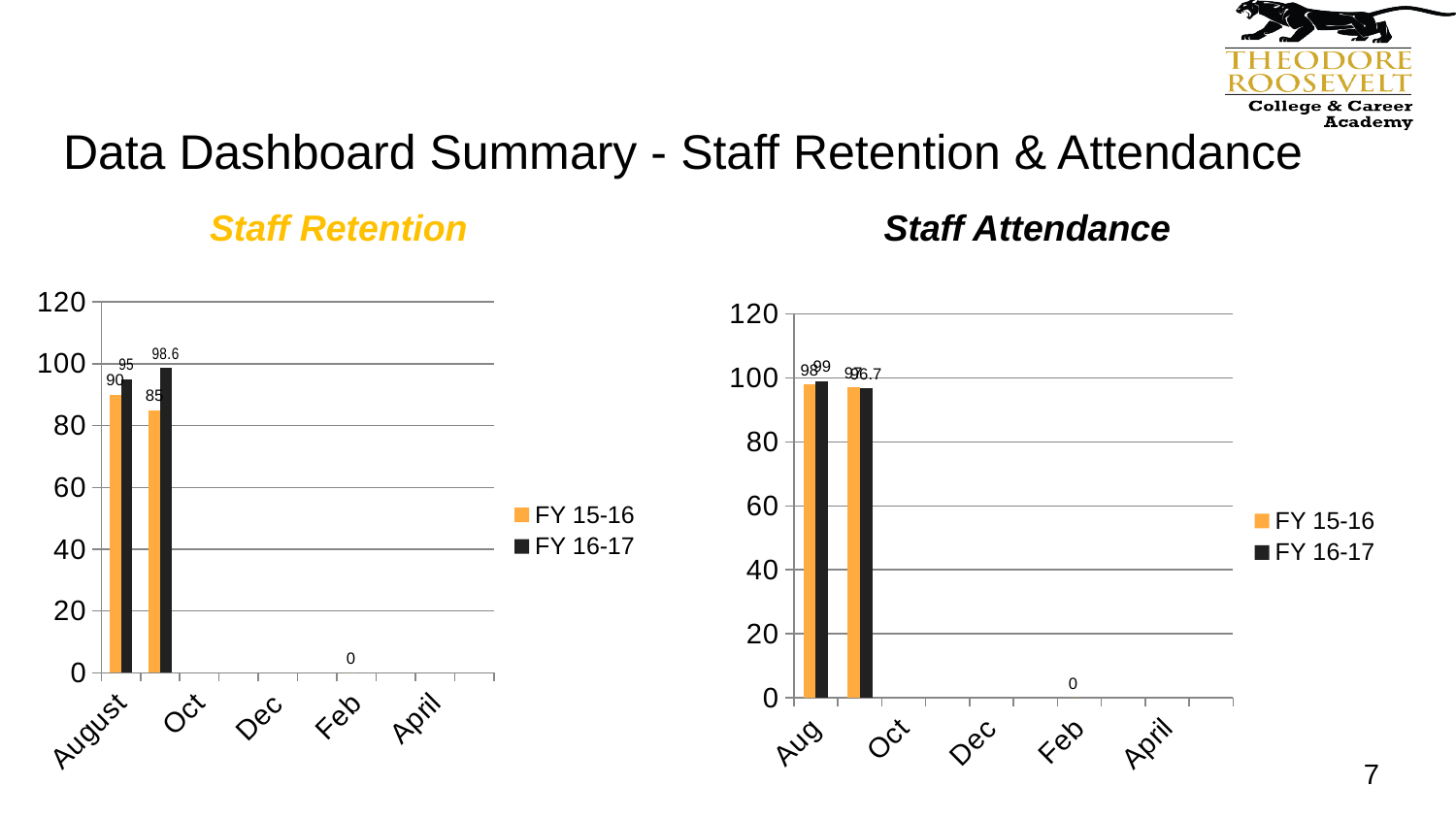
What are the two series named in the legend of the Staff Retention chart? FY 15-16 and FY 16-17 In the Staff Attendance chart, what is the value for FY 16-17 in Aug? 99 In the Staff Attendance chart, which colour represents the FY 15-16 series? orange In the Staff Attendance chart, what is the value for FY 15-16 in Aug? 98 In the Staff Retention chart, what is the highest labelled value? 98.6 In the Staff Retention chart, is the value for FY 15-16 in August greater or less than 100? less How many series does the legend of the Staff Attendance chart list? 2 In the Staff Retention chart, what is the value for FY 16-17 in August? 95 In the Staff Retention chart, what is the difference between the FY 16-17 and FY 15-16 values in August? 5 In the Staff Attendance chart, which series has the larger value in Aug, FY 15-16 or FY 16-17? FY 16-17 In the Staff Retention chart, what is the value for FY 15-16 in August? 90 What kind of chart is the Staff Retention chart? bar chart